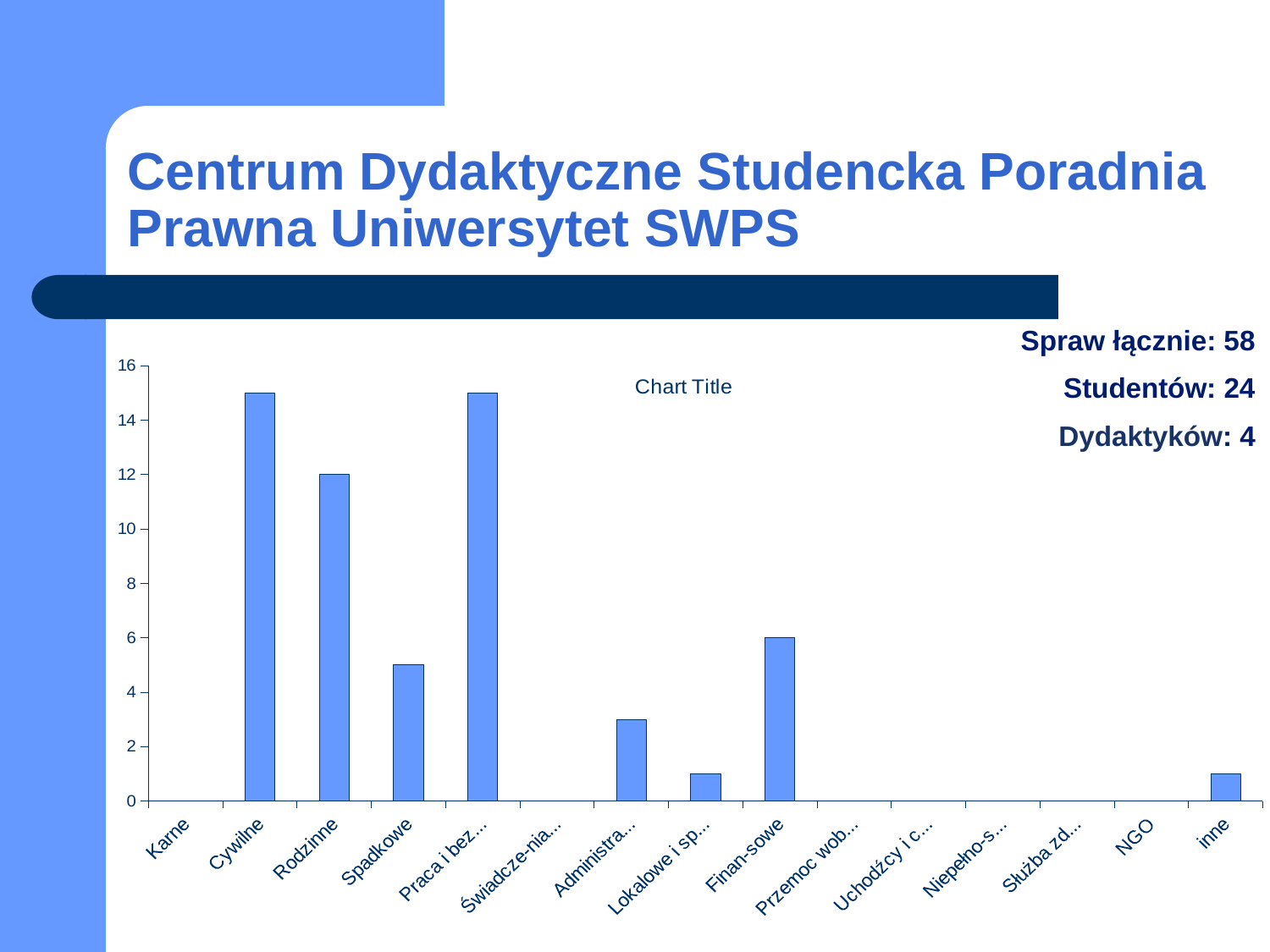
Is the value for Spadkowe greater or less than 4? greater What is the value for Finan-sowe? 6 What is the difference between the values for Rodzinne and Finan-sowe? 6 Is the value for Cywilne greater or less than 14? greater Is the value for Administra... greater or less than 4? less How many categories are shown on the x axis of the chart? 15 Which is larger, the value for Finan-sowe or the value for Administra...? Finan-sowe What is the value for Rodzinne? 12 What type of chart is shown on the slide? bar chart Which is larger, the value for Rodzinne or the value for Spadkowe? Rodzinne What is the title shown on the chart? Chart Title